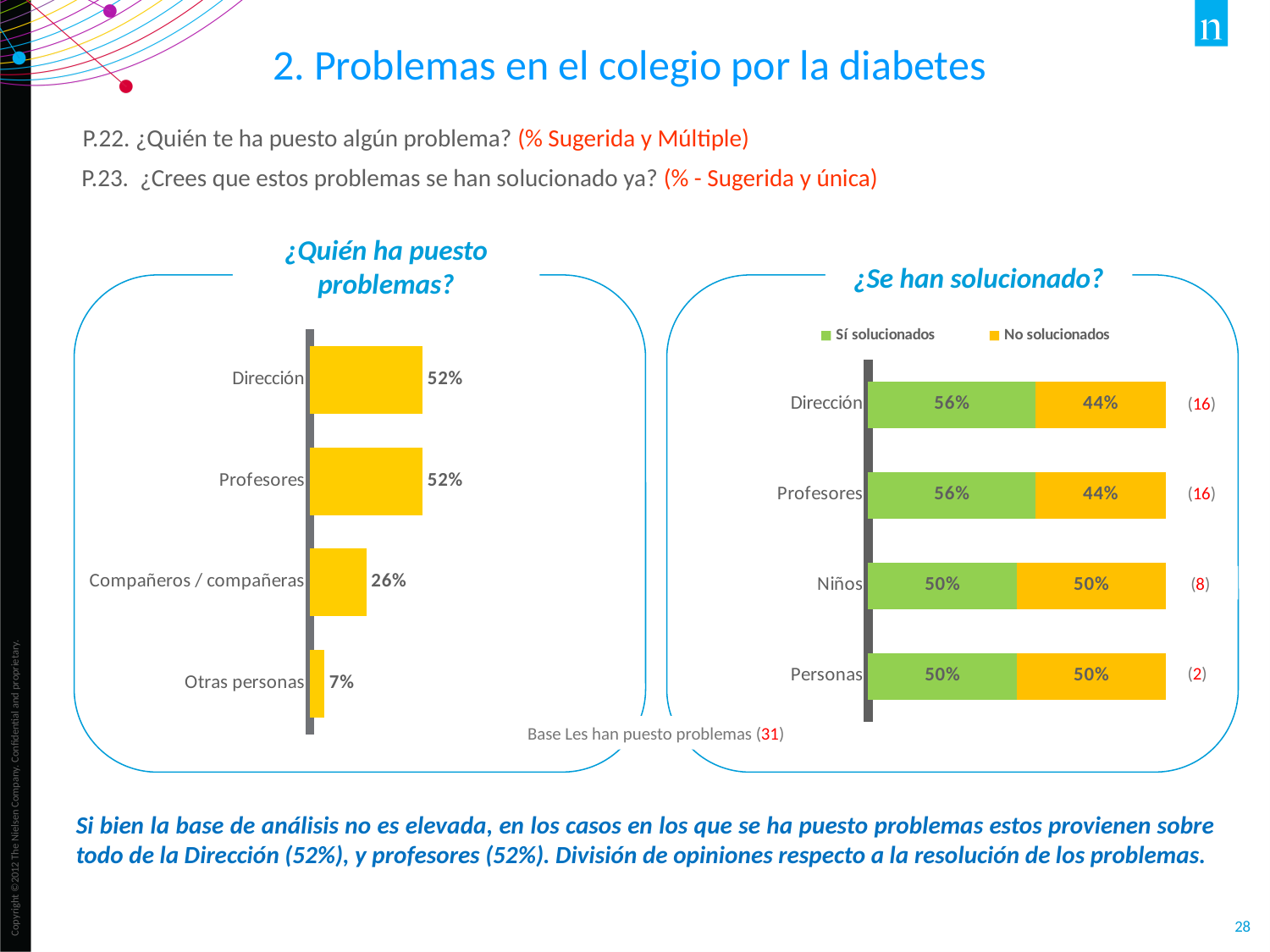
What kind of chart is the '¿Se han solucionado?' chart? Stacked bar chart In the '¿Quién ha puesto problemas?' chart, what is the value for Otras personas? 7% In the '¿Quién ha puesto problemas?' chart, which is larger, the value for Compañeros / compañeras or Otras personas? Compañeros / compañeras In the '¿Se han solucionado?' chart, how many series does the legend list? 2 In the '¿Se han solucionado?' chart, what is the 'No solucionados' value for Niños? 50% In the '¿Quién ha puesto problemas?' chart, what is the difference between the values for Profesores and Compañeros / compañeras? 26% In the '¿Se han solucionado?' chart, what is the total of the stacked bar for Profesores? 100% In the '¿Quién ha puesto problemas?' chart, which category has the lowest value? Otras personas In the '¿Quién ha puesto problemas?' chart, what is the value for Compañeros / compañeras? 26% In the '¿Se han solucionado?' chart, what colour represents 'No solucionados'? Yellow In the '¿Quién ha puesto problemas?' chart, how many categories are shown? 4 In the '¿Se han solucionado?' chart, what is the 'Sí solucionados' value for Dirección? 56%